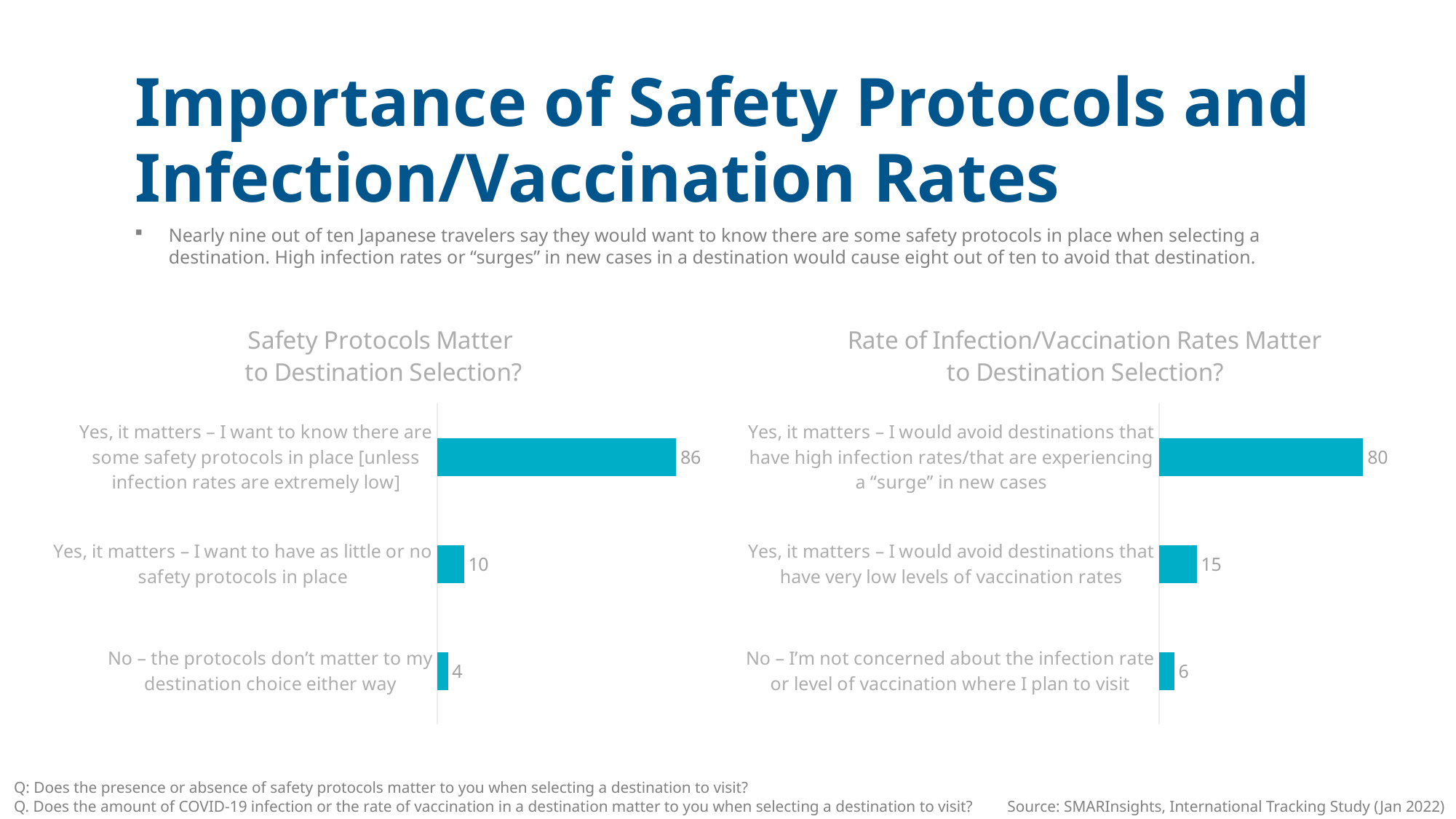
How many categories are shown in the 'Rate of Infection/Vaccination Rates Matter to Destination Selection?' chart? 3 Which is larger: the value for 'Yes, it matters – I want to know there are some safety protocols in place' in the left chart, or the value for 'Yes, it matters – I would avoid destinations that have high infection rates' in the right chart? Yes, it matters – I want to know there are some safety protocols in place (86) In the 'Rate of Infection/Vaccination Rates Matter to Destination Selection?' chart, which category has the lowest value? No – I'm not concerned about the infection rate or level of vaccination where I plan to visit In the 'Safety Protocols Matter to Destination Selection?' chart, what is the value for 'Yes, it matters – I want to know there are some safety protocols in place'? 86 In the 'Rate of Infection/Vaccination Rates Matter to Destination Selection?' chart, what is the value for 'No – I'm not concerned about the infection rate or level of vaccination where I plan to visit'? 6 What type of chart is the 'Safety Protocols Matter to Destination Selection?' chart? Bar chart In the 'Safety Protocols Matter to Destination Selection?' chart, what is the difference between the value for wanting to know there are some safety protocols in place (86) and wanting as little or no safety protocols (10)? 76 In the 'Rate of Infection/Vaccination Rates Matter to Destination Selection?' chart, what is the difference between the value for avoiding destinations with high infection rates and the value for avoiding destinations with very low vaccination rates? 65 In the 'Safety Protocols Matter to Destination Selection?' chart, what is the value for 'No – the protocols don't matter to my destination choice either way'? 4 In the 'Rate of Infection/Vaccination Rates Matter to Destination Selection?' chart, what is the value for 'Yes, it matters – I would avoid destinations that have very low levels of vaccination rates'? 15 In the 'Safety Protocols Matter to Destination Selection?' chart, which category has the highest value? Yes, it matters – I want to know there are some safety protocols in place [unless infection rates are extremely low] What is the title of the chart on the right side of the slide? Rate of Infection/Vaccination Rates Matter to Destination Selection?